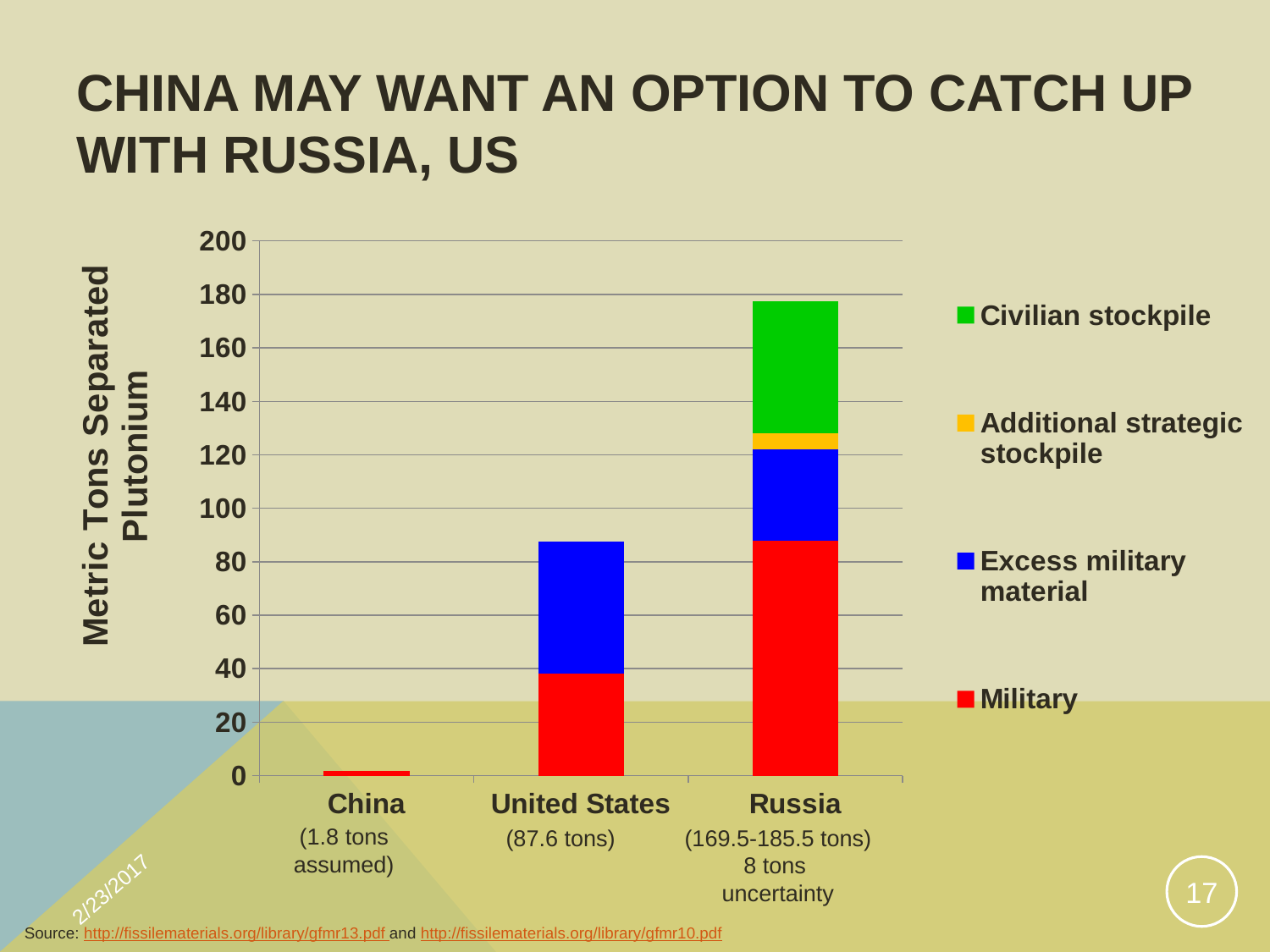
What is the title of the chart's y axis? Metric Tons Separated Plutonium How many countries are shown on the x axis of the chart? 3 According to the label under the bar, how many tons of separated plutonium are assumed for China? 1.8 tons What kind of chart is shown on the slide? Stacked bar chart Which has a larger total stacked bar, the United States or Russia? Russia Which country has the tallest stacked bar in the chart? Russia According to the label under the bar, how many tons of separated plutonium does the United States have? 87.6 tons How many series does the chart's legend list? 4 Which country has the shortest stacked bar in the chart? China Is the total stacked value for Russia greater or less than 160? greater Is the Military segment for Russia greater or less than 80? greater What range of tons is printed under the Russia bar? 169.5-185.5 tons